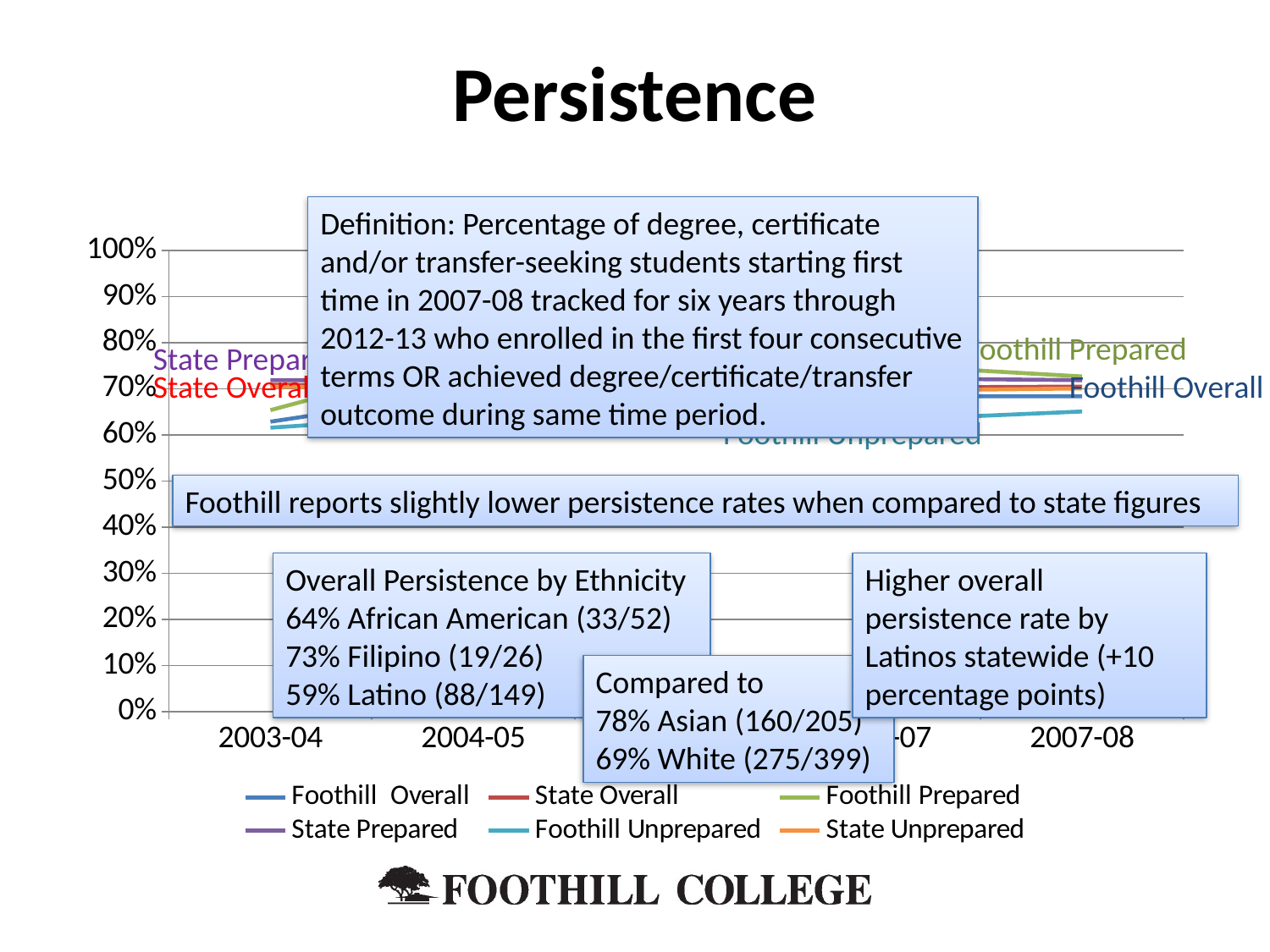
What kind of chart is shown on the slide? line chart In 2007-08, which is higher: Foothill Prepared or Foothill Unprepared? Foothill Prepared Does the Foothill Prepared line rise or fall from 2003-04 to 2007-08? rise How many series does the chart legend list? 6 Is the value for Foothill Unprepared in 2007-08 greater or less than 70%? less Is the value for Foothill Unprepared in 2003-04 greater or less than 70%? less What is the title of the slide containing the chart? Persistence Is the value for Foothill Overall in 2007-08 greater or less than 60%? greater Which series are listed in the chart legend? Foothill Overall, State Overall, Foothill Prepared, State Prepared, Foothill Unprepared, State Unprepared